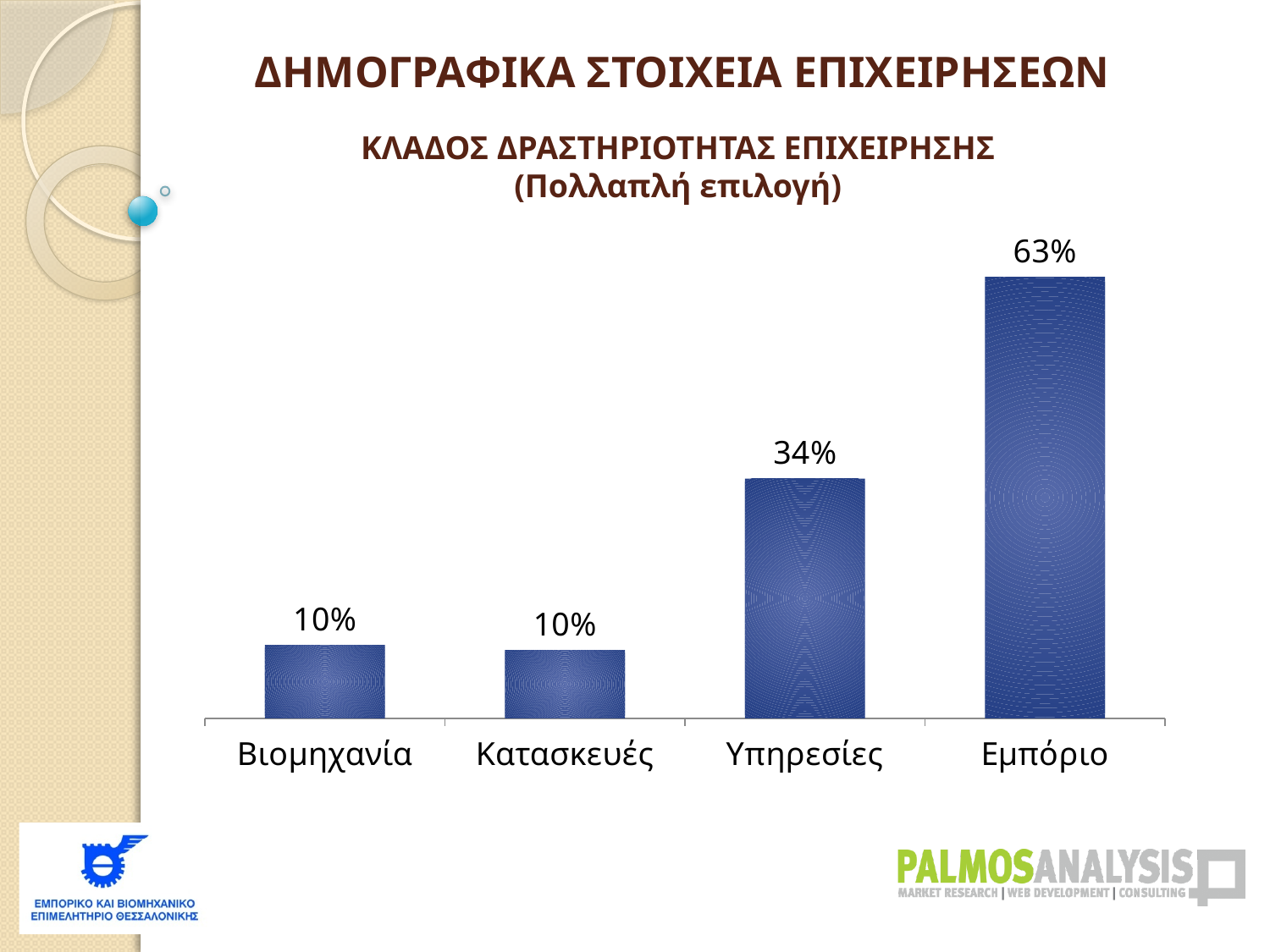
What is the title of the chart? ΚΛΑΔΟΣ ΔΡΑΣΤΗΡΙΟΤΗΤΑΣ ΕΠΙΧΕΙΡΗΣΗΣ (Πολλαπλή επιλογή) What is the difference between the values for Εμπόριο and Υπηρεσίες? 29% What kind of chart is shown on the slide? Bar chart What is the value for Εμπόριο? 63% Do the values rise or fall from left to right along the x axis? Rise Which is larger, the value for Υπηρεσίες or the value for Βιομηχανία? Υπηρεσίες What is the value for Βιομηχανία? 10% Which category has the highest value? Εμπόριο What is the difference between the values for Υπηρεσίες and Κατασκευές? 24% How many categories are shown on the chart? 4 What is the value for Υπηρεσίες? 34% What is the value for Κατασκευές? 10%